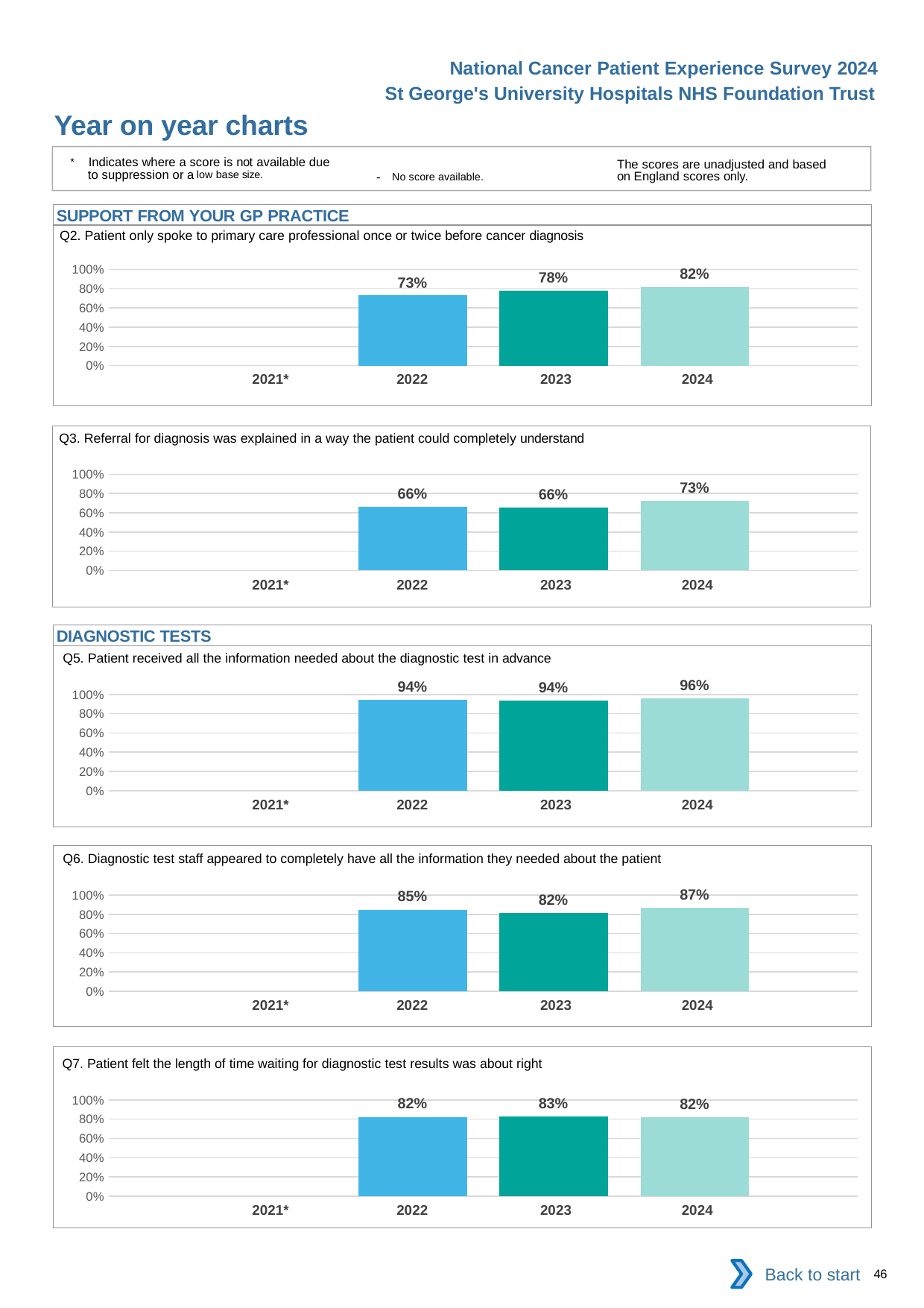
What kind of chart is used for Q2? Bar chart In the Q2 chart, what is the value for 2024? 82% In the Q3 chart, what is the value for 2023? 66% In the Q6 chart, which is larger, the value for 2022 or the value for 2023? 2022 In the Q3 chart, which year has the highest value? 2024 In the Q7 chart, what is the value for 2023? 83% In the Q5 chart, is the value for 2022 greater or less than 80%? greater How many years are shown on the x axis of the Q7 chart? 4 In the Q5 chart, what is the value for 2024? 96% In the Q6 chart, what is the difference between the 2024 and 2023 values? 5% In the Q2 chart, what is the difference between the 2024 and 2022 values? 9% In the Q2 chart, which year has the lowest plotted value? 2022